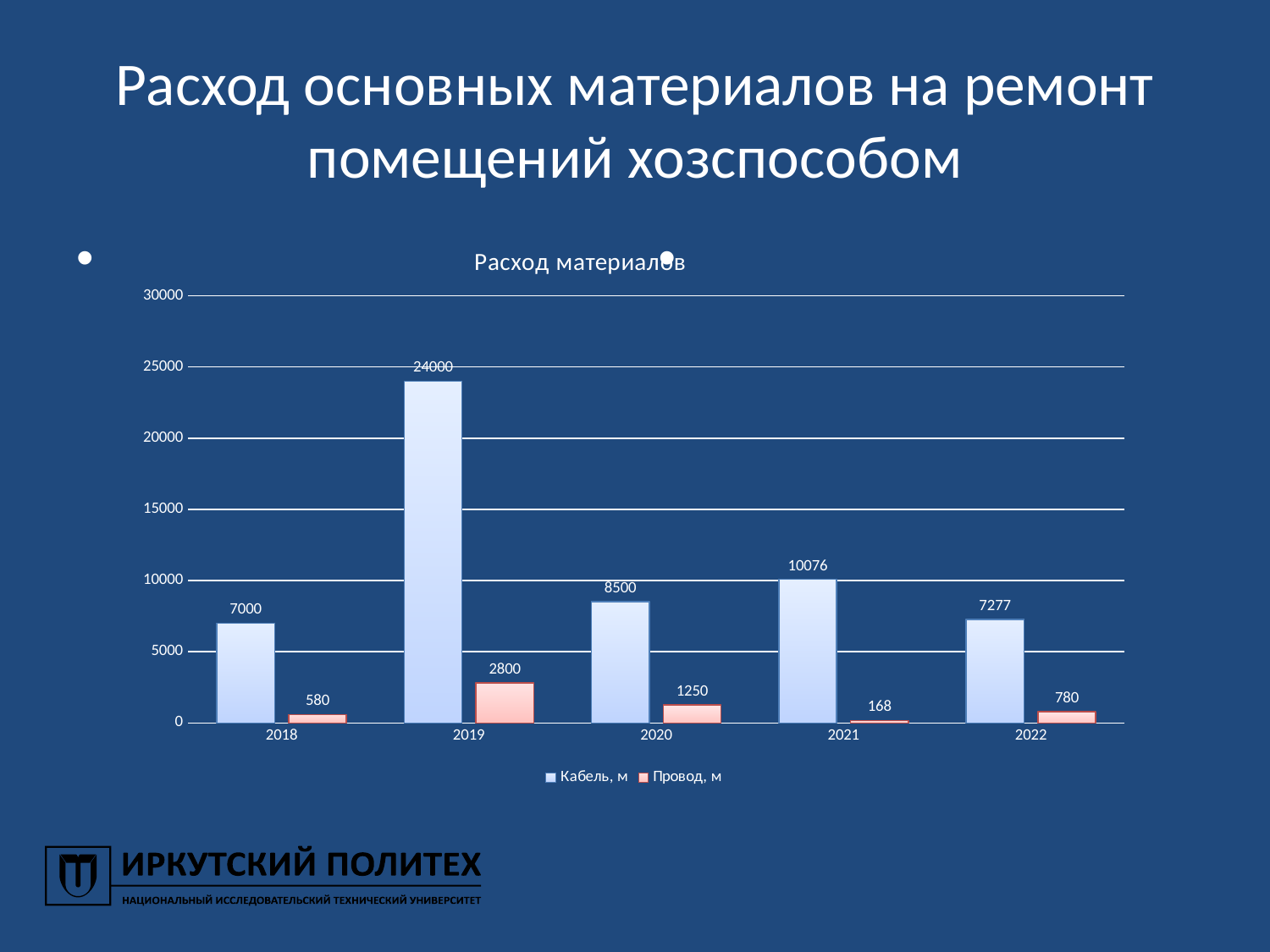
Is the value for Кабель, м in 2021 greater or less than 10000? greater What is the value for Кабель, м in 2019? 24000 What is the difference between the Кабель, м values for 2021 and 2020? 1576 Which is larger: Провод, м in 2018 or Провод, м in 2022? 2022 Which year has the lowest value for Провод, м? 2021 Which year has the highest value for Кабель, м? 2019 How many series does the legend list? 2 What kind of chart is shown? bar chart What is the value for Провод, м in 2021? 168 What is the value for Кабель, м in 2022? 7277 What is the title of the chart? Расход материалов How many years are shown on the x axis? 5